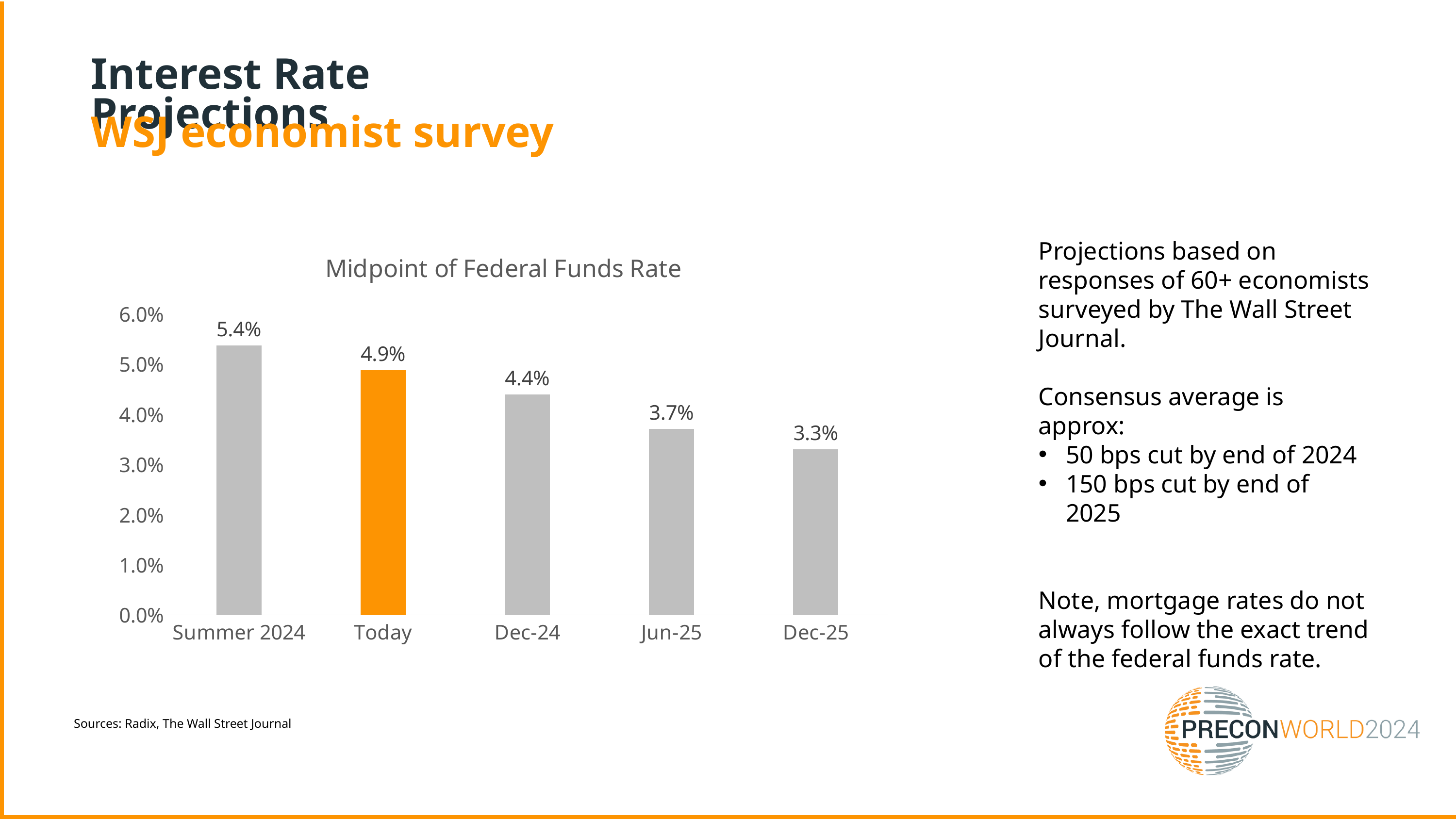
Do the values rise or fall from Summer 2024 to Dec-25? fall Is the value for Jun-25 greater or less than 4.0%? less What is the projected midpoint of the federal funds rate for Dec-25? 3.3% Which category has the highest midpoint of the federal funds rate? Summer 2024 Which category has the lowest midpoint of the federal funds rate? Dec-25 What is the difference between the Today value and the Dec-24 value? 0.5% What is the midpoint of the federal funds rate for Summer 2024? 5.4% How many categories are shown on the x axis of the chart? 5 What is the difference between the Summer 2024 value and the Dec-25 value? 2.1% Which is larger, the value for Jun-25 or the value for Dec-24? Dec-24 What kind of chart is shown on the slide? bar chart What is the midpoint of the federal funds rate for Today? 4.9%